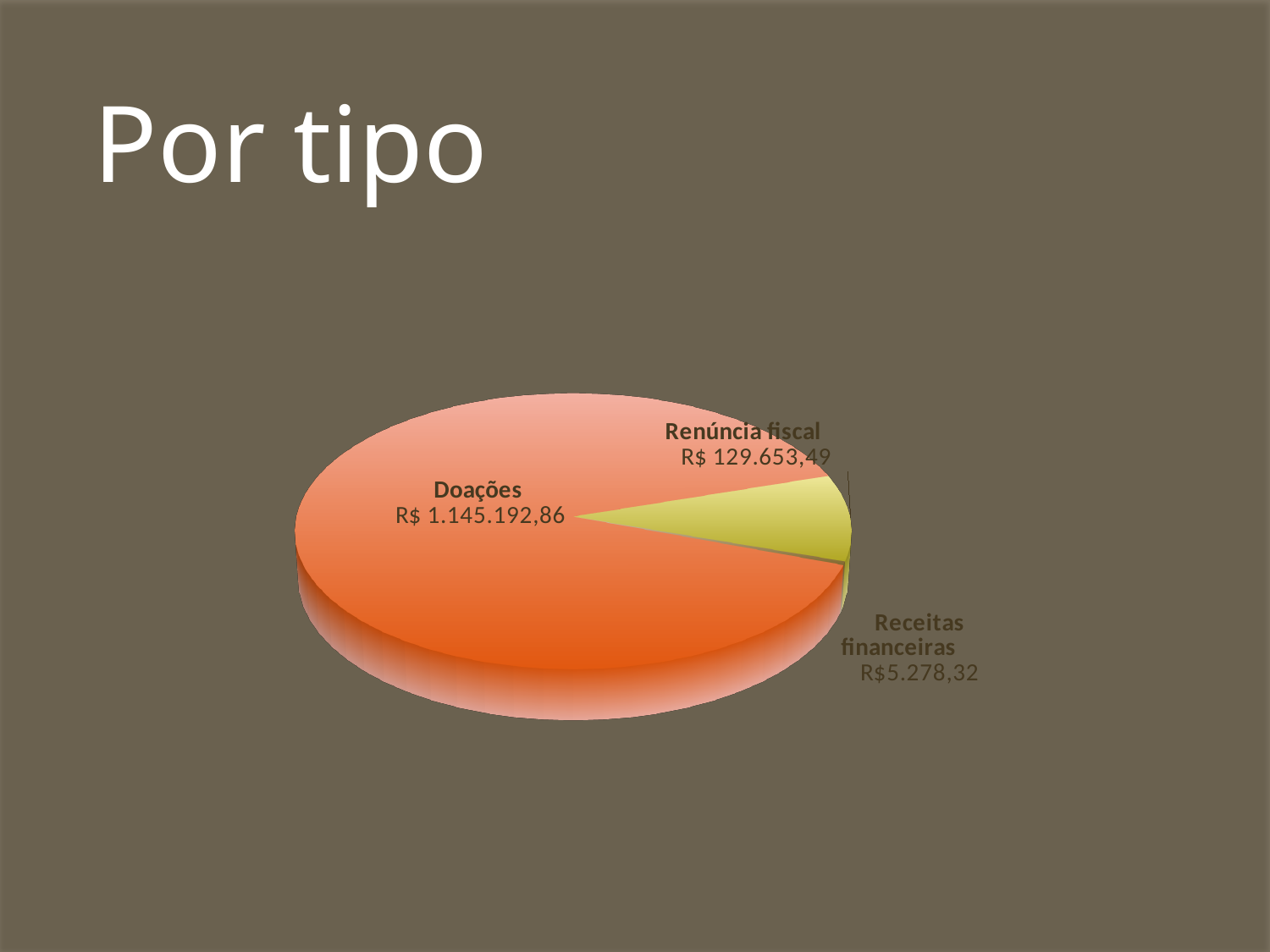
Which is larger, Renúncia fiscal or Receitas financeiras? Renúncia fiscal What colour is the Doações slice of the pie? Orange What is the value shown for Receitas financeiras? R$5.278,32 What is the difference between the values for Doações and Renúncia fiscal? R$ 1.015.539,37 What is the title of the slide containing the pie chart? Por tipo What is the value shown for Doações? R$ 1.145.192,86 Which category has the largest slice of the pie? Doações What type of chart is shown on the slide? Pie chart What is the difference between the values for Renúncia fiscal and Receitas financeiras? R$ 124.375,17 How many slices does the pie chart have? 3 Which category has the smallest slice of the pie? Receitas financeiras What is the value shown for Renúncia fiscal? R$ 129.653,49